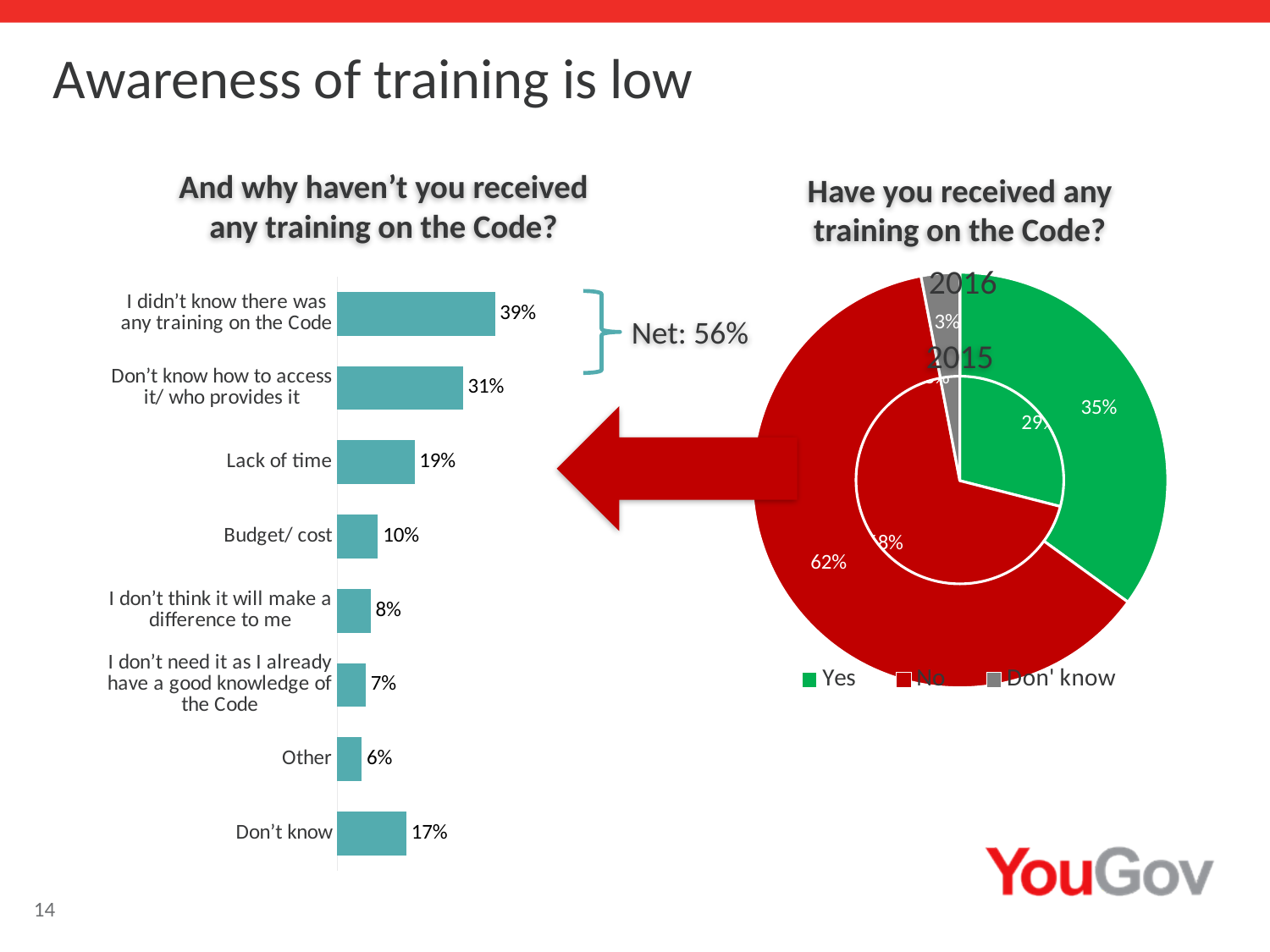
In the chart 'And why haven't you received any training on the Code?', which reason has the highest percentage? I didn't know there was any training on the Code In the chart 'And why haven't you received any training on the Code?', which is larger: 'Lack of time' or 'Don't know'? Lack of time How many entries does the legend of the 'Have you received any training on the Code?' chart list? 3 In the 'Have you received any training on the Code?' chart, what percentage of the 2016 pie answered 'Yes'? 35% In the chart 'And why haven't you received any training on the Code?', what is the difference between 'Don't know how to access it/ who provides it' and 'Budget/ cost'? 21 percentage points In the 'Have you received any training on the Code?' chart, what percentage of the 2016 pie answered 'No'? 62% In the chart 'And why haven't you received any training on the Code?', what percentage is shown for 'I didn't know there was any training on the Code'? 39% How many reasons are listed in the chart 'And why haven't you received any training on the Code?'? 8 In the chart 'And why haven't you received any training on the Code?', which reason has the lowest percentage? Other In the chart 'And why haven't you received any training on the Code?', what percentage is shown for 'Lack of time'? 19% In the chart 'And why haven't you received any training on the Code?', what percentage is shown for 'Don't know'? 17% What type of chart is 'And why haven't you received any training on the Code?'? Bar chart